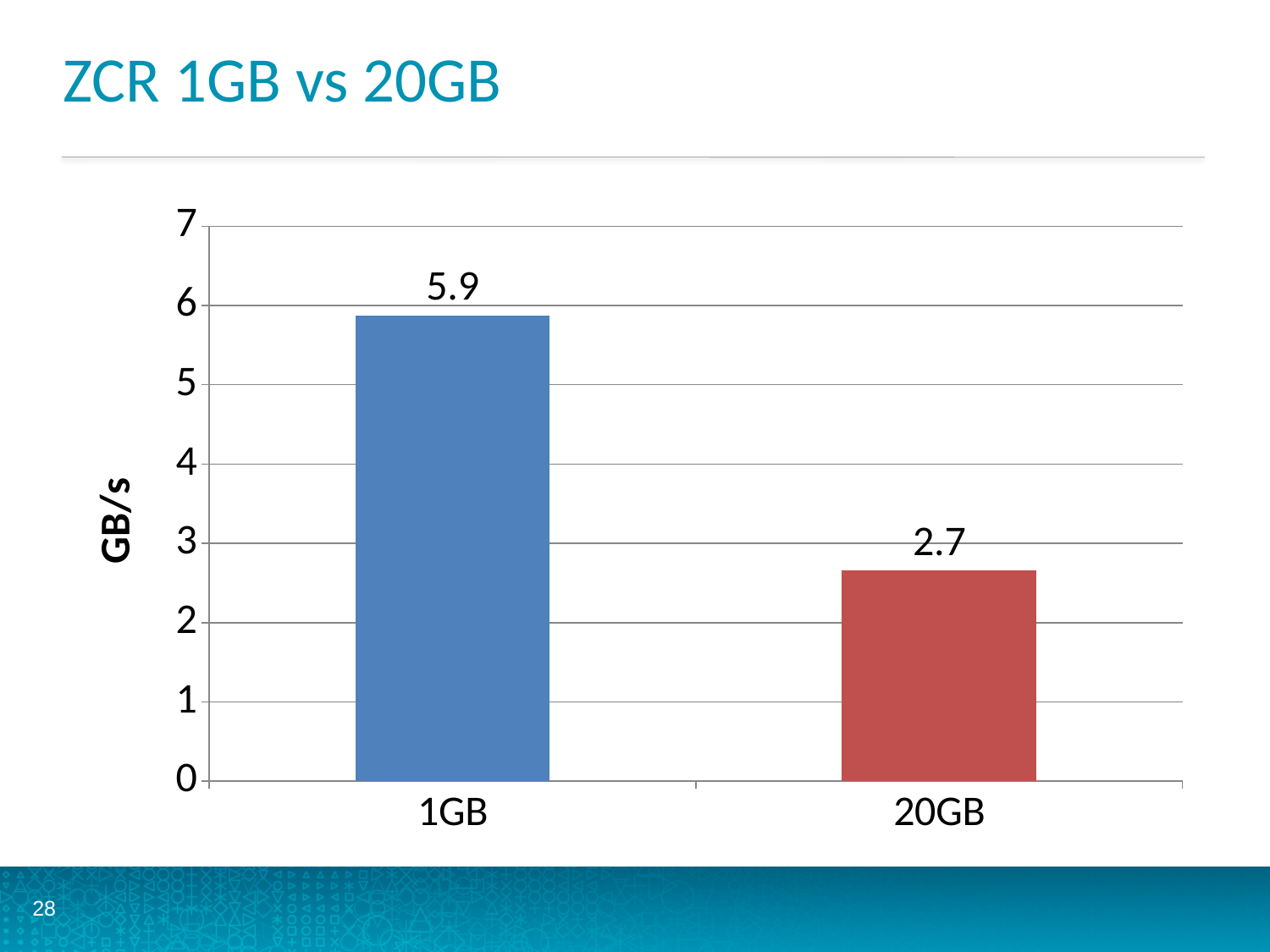
What is the value for 20GB? 2.7 Which is larger, the value for 1GB or the value for 20GB? 1GB Do the values rise or fall from 1GB to 20GB? fall Which category has the lowest value? 20GB How many categories are shown on the x axis? 2 Is the value for 20GB greater or less than 3? less What is the difference between the values for 1GB and 20GB? 3.2 Which category has the highest value? 1GB What is the label on the y axis? GB/s What is the value for 1GB? 5.9 What kind of chart is shown on the slide? bar chart Is the value for 1GB greater or less than 5? greater